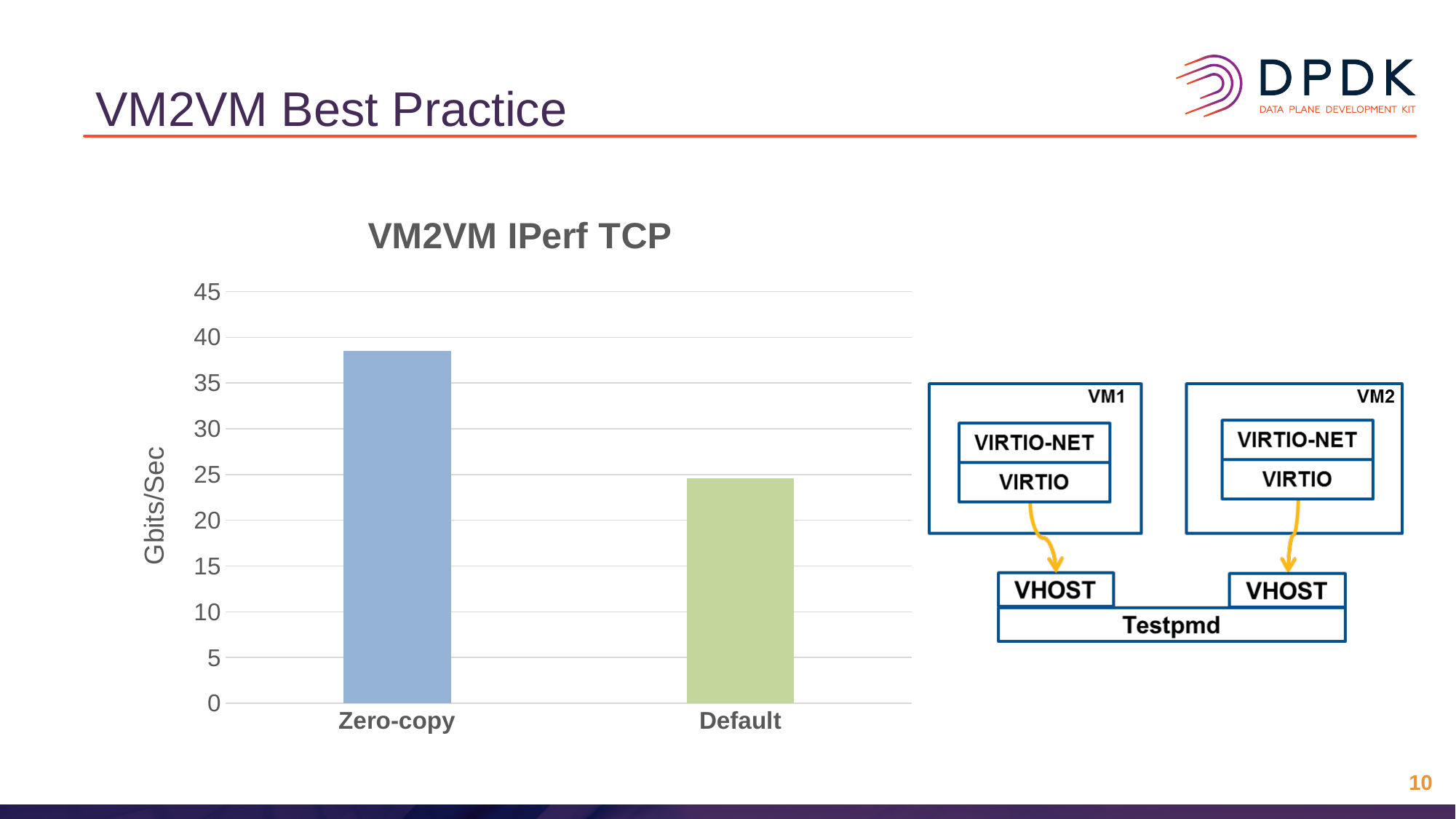
Is the value for Default greater or less than 20? greater Which category has the lowest value? Default Do the values fall or rise from Zero-copy to Default along the x axis? fall Which category has the highest value? Zero-copy Is the value for Default greater or less than 30? less Which is larger, the value for Zero-copy or the value for Default? Zero-copy What is the title of the chart? VM2VM IPerf TCP Is the value for Zero-copy greater or less than 40? less What is the label on the vertical axis of the chart? Gbits/Sec How many categories are plotted in the chart? 2 What type of chart is shown on the slide? bar chart